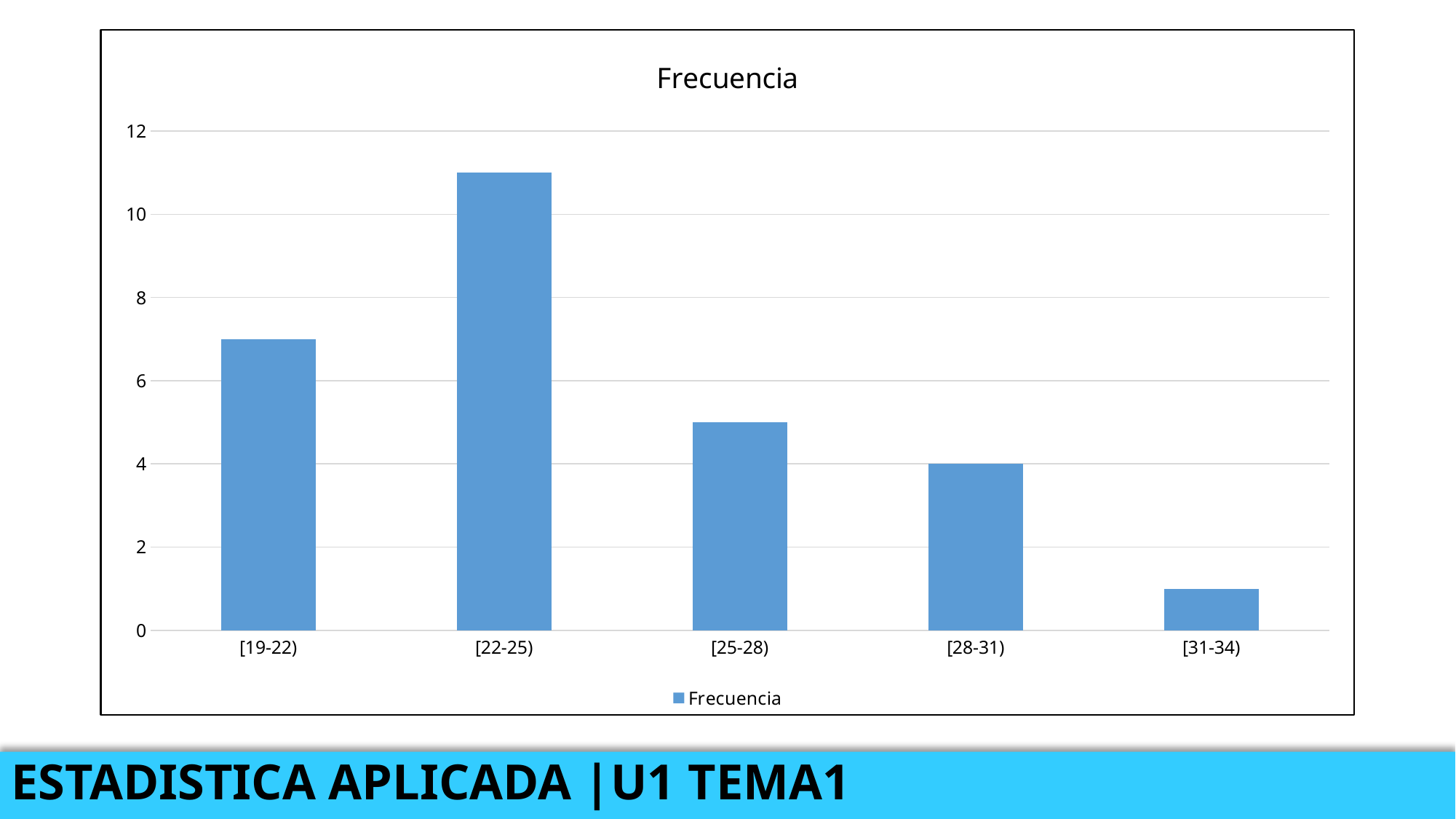
Is the value for [25-28) greater or less than 6? less Which is larger, the value for [19-22) or the value for [25-28)? [19-22) How many series does the legend list? 1 Which category has the highest frequency? [22-25) Which category has the lowest frequency? [31-34) Is the value for [19-22) greater or less than 6? greater What is the value for [28-31)? 4 Do the values rise or fall from [22-25) to [31-34)? fall What kind of chart is shown on the slide? bar chart How many categories are shown on the x axis of the chart? 5 Is the value for [22-25) greater or less than 10? greater What is the title of the chart? Frecuencia